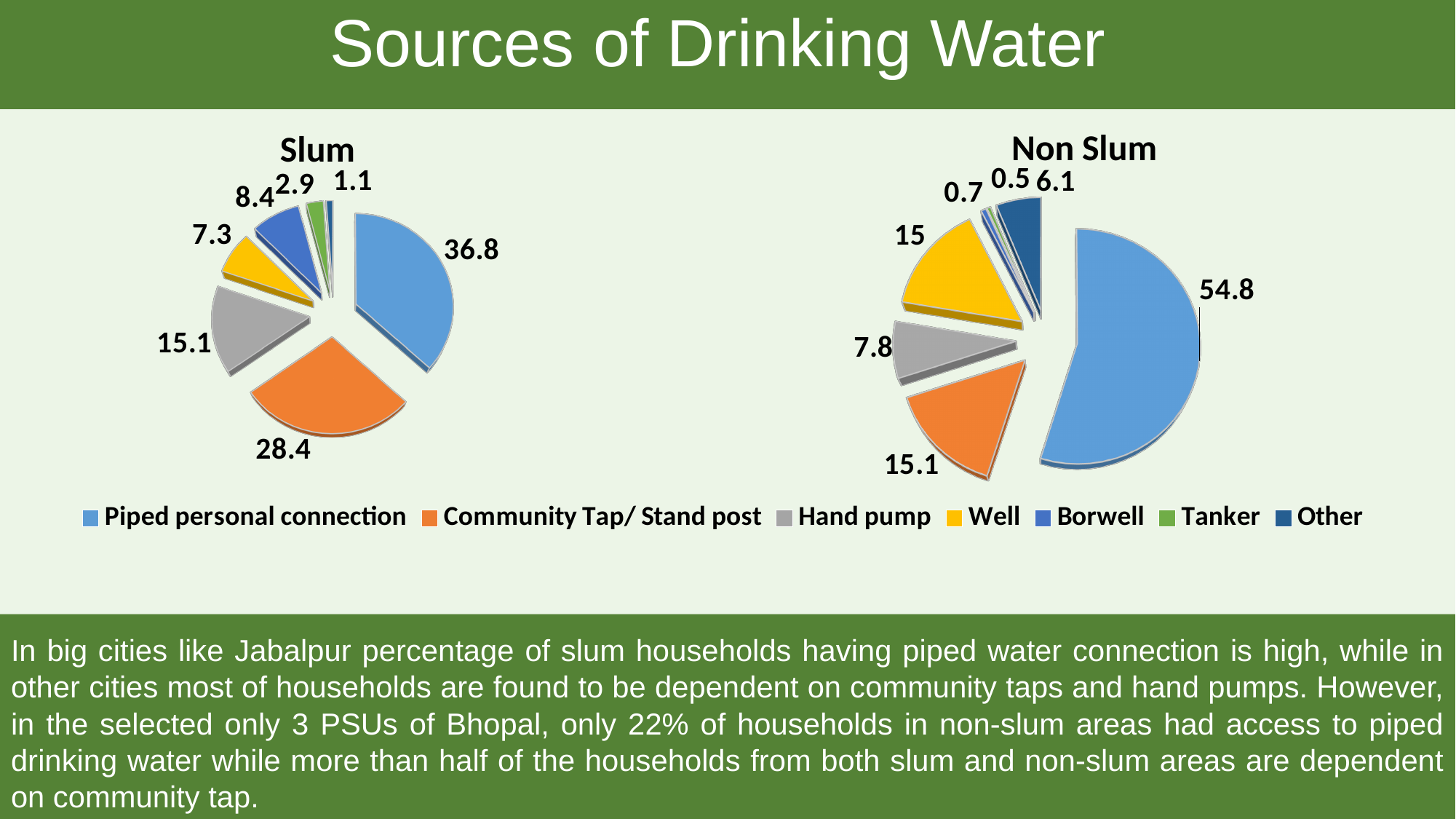
What colour represents Hand pump in the legend? Grey In the Non Slum chart, what is the value for Well? 15 In the Slum chart, which source has the largest share? Piped personal connection In the Non Slum chart, what is the value for Borwell? 0.7 In the Slum chart, what is the difference between the Piped personal connection and Community Tap/ Stand post values? 8.4 In the Slum chart, what is the value for Community Tap/ Stand post? 28.4 In the Non Slum chart, what is the value for Piped personal connection? 54.8 How many categories does the legend list? 7 In the Non Slum chart, which source has the smallest share? Tanker In the Non Slum chart, which is larger: Hand pump or Other? Hand pump What kind of charts are shown on the slide? Pie charts In the Slum chart, what is the value for Piped personal connection? 36.8